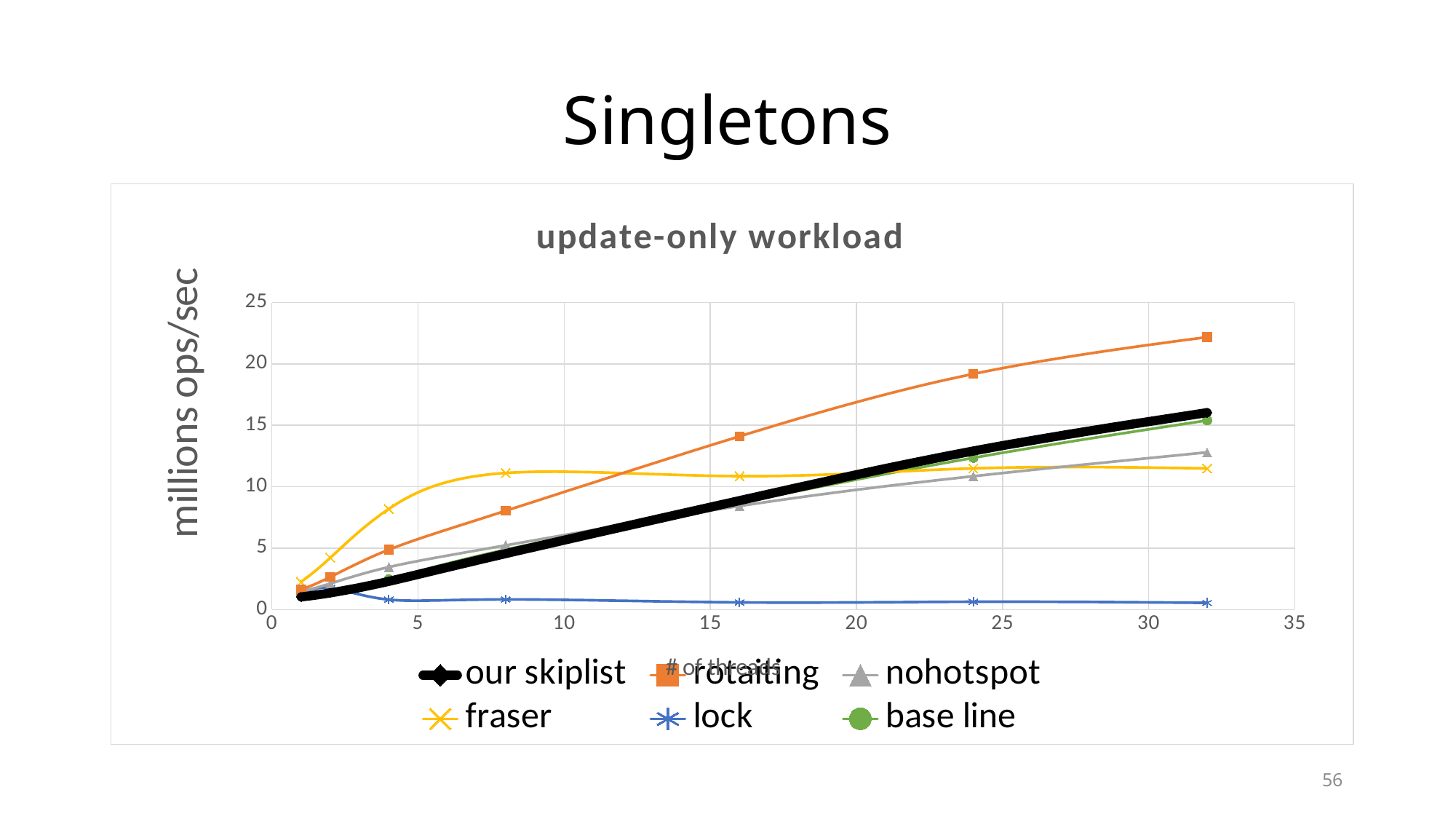
What is the title of the chart? update-only workload Is the value for lock at 32 threads greater or less than 5? less Which series has the highest value at 32 threads? rotaiting What is the label on the y axis? millions ops/sec How many series does the legend list? 6 Is the value for rotaiting at 32 threads greater or less than 20? greater Does the rotaiting series rise or fall as the number of threads increases? rise At 16 threads, which is larger: rotaiting or fraser? rotaiting At 4 threads, which is larger: fraser or rotaiting? fraser Is the value for fraser at 8 threads greater or less than 10? greater Which series has the lowest value at 32 threads? lock What kind of chart is shown on the slide? line chart